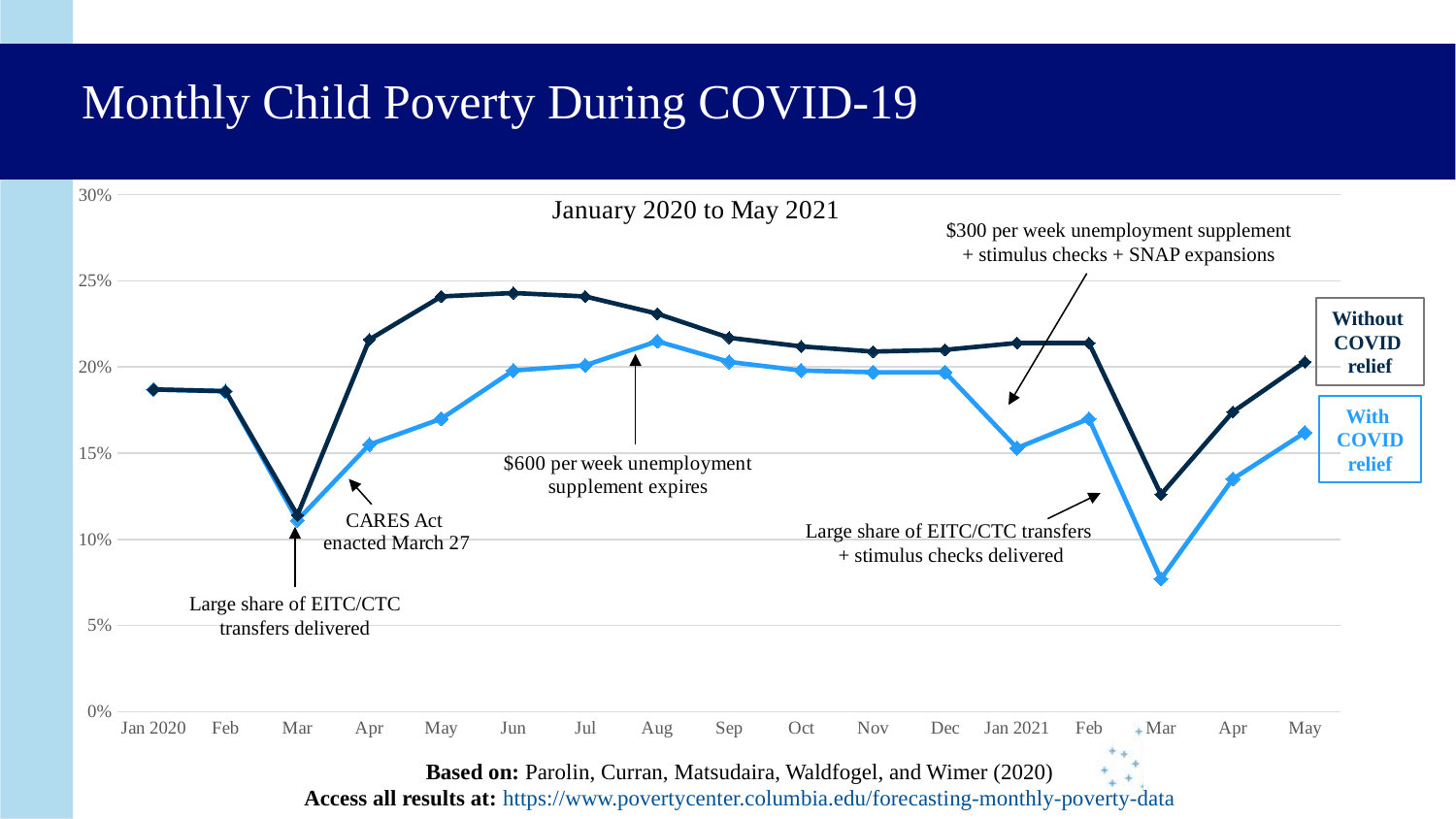
Is the value for With COVID relief in Aug 2020 greater or less than 20%? greater In which month is the With COVID relief series at its lowest? Mar 2021 Does the Without COVID relief series rise or fall from Mar 2020 to Jun 2020? Rise How many series does the chart show? 2 What is the title of the chart? Monthly Child Poverty During COVID-19 What kind of chart is shown on the slide? Line chart In Jan 2021, which series has the higher value: Without COVID relief or With COVID relief? Without COVID relief Is the value for With COVID relief in Mar 2021 greater or less than 10%? less In which month is the With COVID relief series at its highest? Aug 2020 Is the value for Without COVID relief in Mar 2021 greater or less than 15%? less How many months are plotted along the x axis? 17